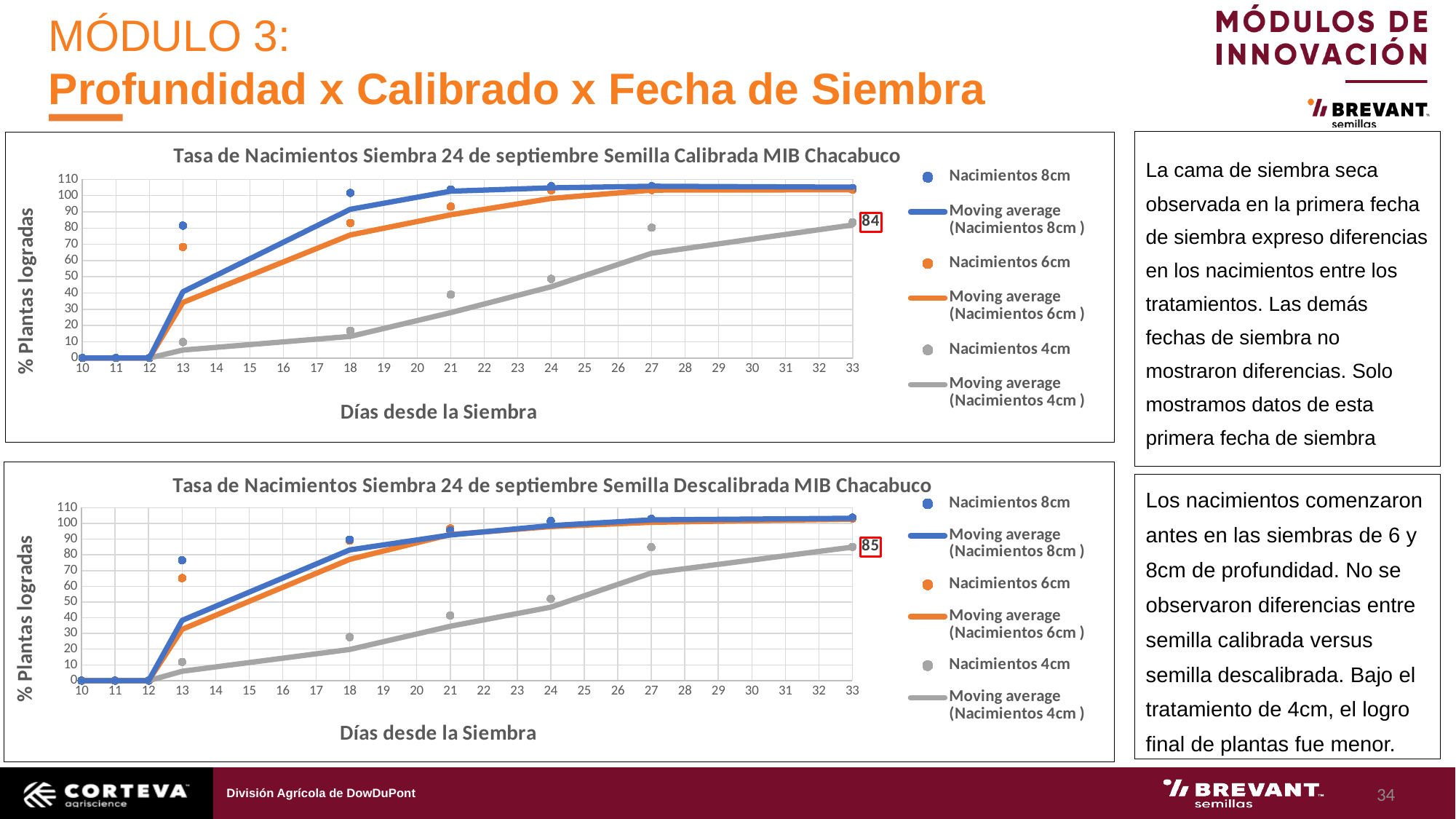
In the bottom chart, does the Moving average (Nacimientos 4cm) line rise or fall as days since sowing increase? rises In the top chart, is the value for Nacimientos 8cm at day 13 greater or less than 70? greater What is the x-axis title of the top chart? Días desde la Siembra In the bottom chart, is the value for Nacimientos 4cm at day 21 greater or less than 60? less What is the y-axis title of the bottom chart? % Plantas logradas In the top chart, at day 13, which is larger: Nacimientos 8cm or Nacimientos 4cm? Nacimientos 8cm In the bottom chart (Semilla Descalibrada), what value is labelled for Nacimientos 4cm at day 33? 85 In the top chart, which series has the lowest value at day 33? Nacimientos 4cm In the top chart, is the value for Nacimientos 4cm at day 13 greater or less than 20? less In the top chart (Semilla Calibrada), what value is labelled for Nacimientos 4cm at day 33? 84 What kind of chart is the bottom chart (Semilla Descalibrada)? Scatter chart with moving average lines How many series does the legend of the top chart list? 6